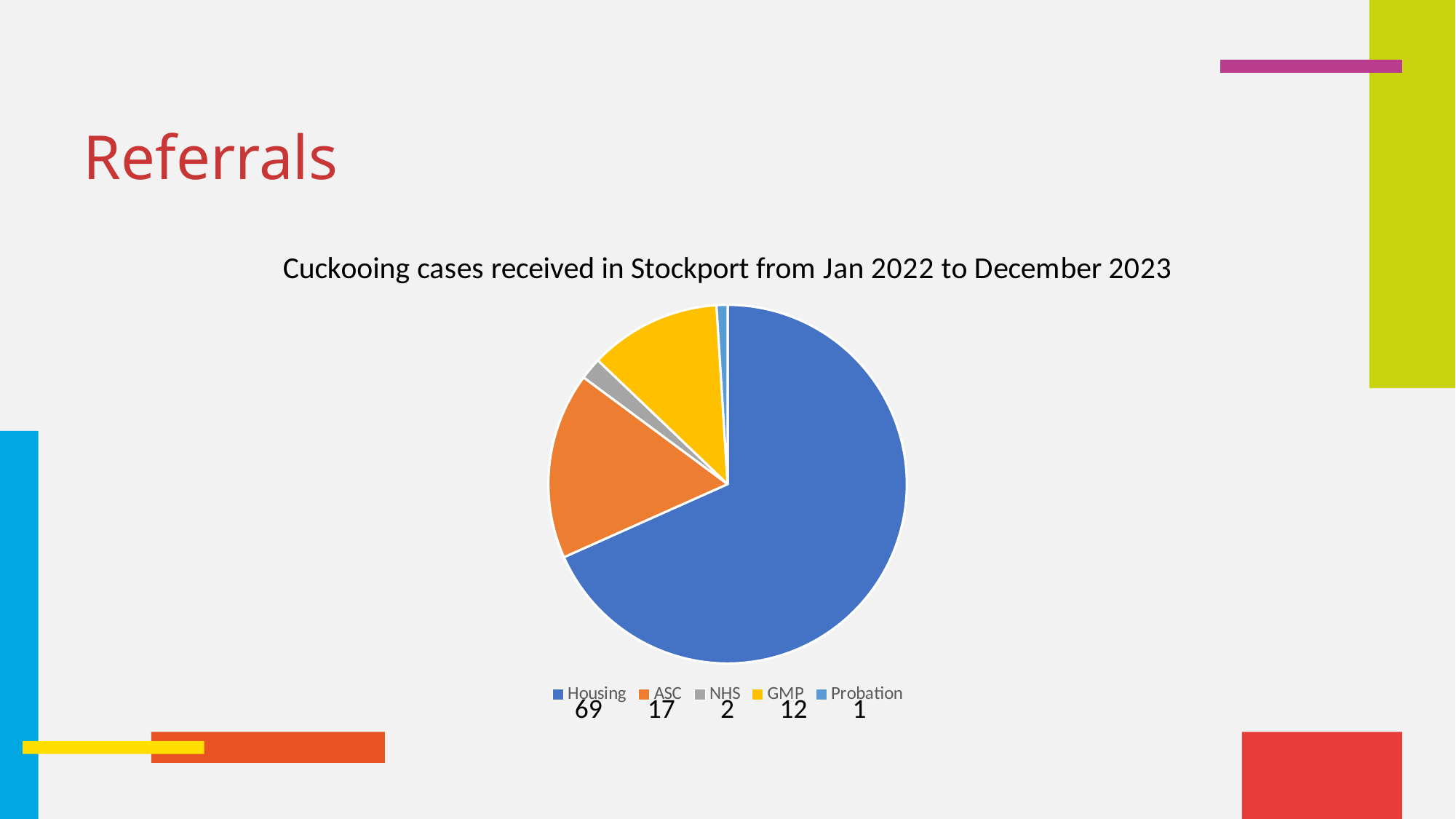
How many more cases were referred by GMP than by NHS? 10 What kind of chart is shown on the slide? pie chart How many cuckooing cases were referred by NHS? 2 What is the title of the chart? Cuckooing cases received in Stockport from Jan 2022 to December 2023 How many referral sources are listed in the legend? 5 Which referred more cases, ASC or GMP? ASC Which referral source has the smallest share of the pie? Probation How many cuckooing cases were referred by Housing? 69 Which referral source has the largest share of the pie? Housing How many cuckooing cases were referred by GMP? 12 How many more cases were referred by Housing than by ASC? 52 How many cuckooing cases were referred by ASC? 17